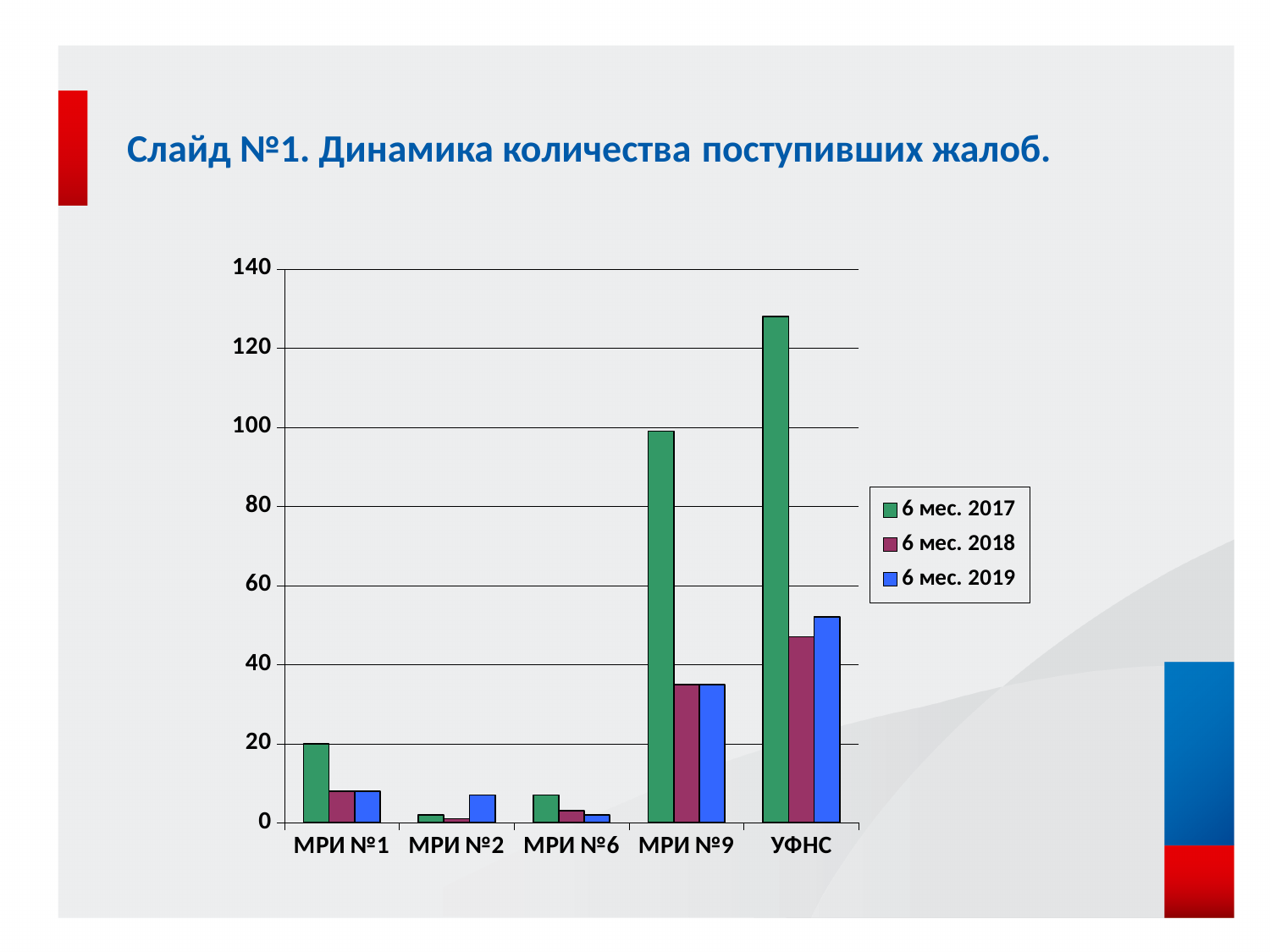
How many categories are shown on the x axis? 5 What kind of chart is shown on the slide? bar chart For УФНС, which series has the highest value? 6 мес. 2017 Which is larger for 6 мес. 2017: МРИ №9 or УФНС? УФНС Which category has the highest value for 6 мес. 2017? УФНС Is the value for УФНС in 6 мес. 2019 greater or less than 60? less Is the value for УФНС in 6 мес. 2017 greater or less than 120? greater What is the first entry listed in the legend? 6 мес. 2017 Is the value for МРИ №9 in 6 мес. 2017 greater or less than 80? greater Which category has the lowest value for 6 мес. 2017? МРИ №2 How many series does the legend list? 3 For МРИ №2, which is larger: the value for 6 мес. 2017 or for 6 мес. 2019? 6 мес. 2019